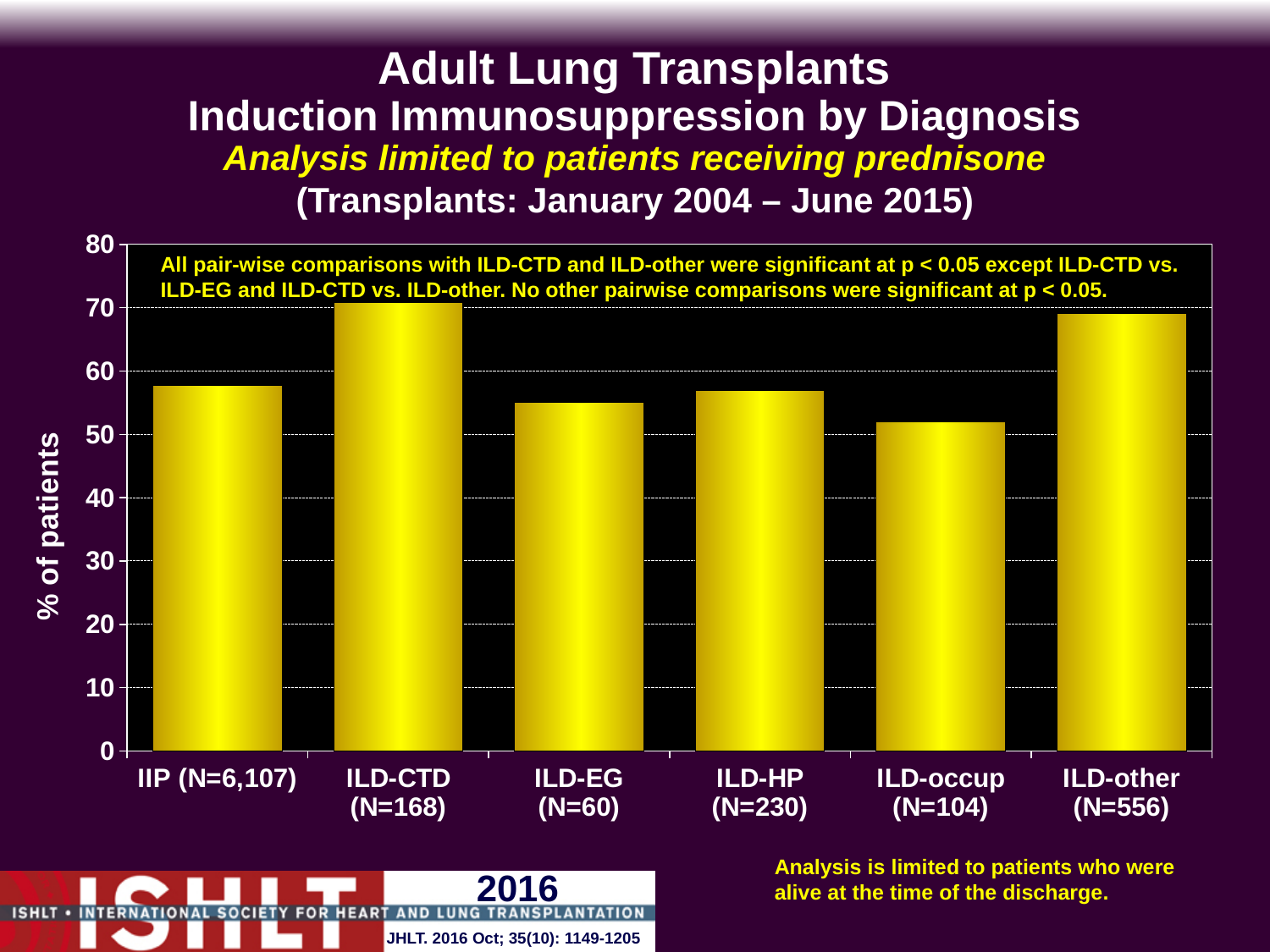
What kind of chart is shown on the slide? bar chart Is the value for IIP greater or less than 60? less What is the label of the y axis? % of patients Is the value for ILD-other greater or less than 70? less Is the value for ILD-occup greater or less than 50? greater Which is larger, the value for ILD-CTD or the value for ILD-occup? ILD-CTD How many diagnosis categories are plotted on the chart? 6 Which diagnosis category has the highest percentage of patients? ILD-CTD (N=168) Which diagnosis category has the lowest percentage of patients? ILD-occup (N=104) Which is larger, the value for ILD-EG or the value for ILD-other? ILD-other